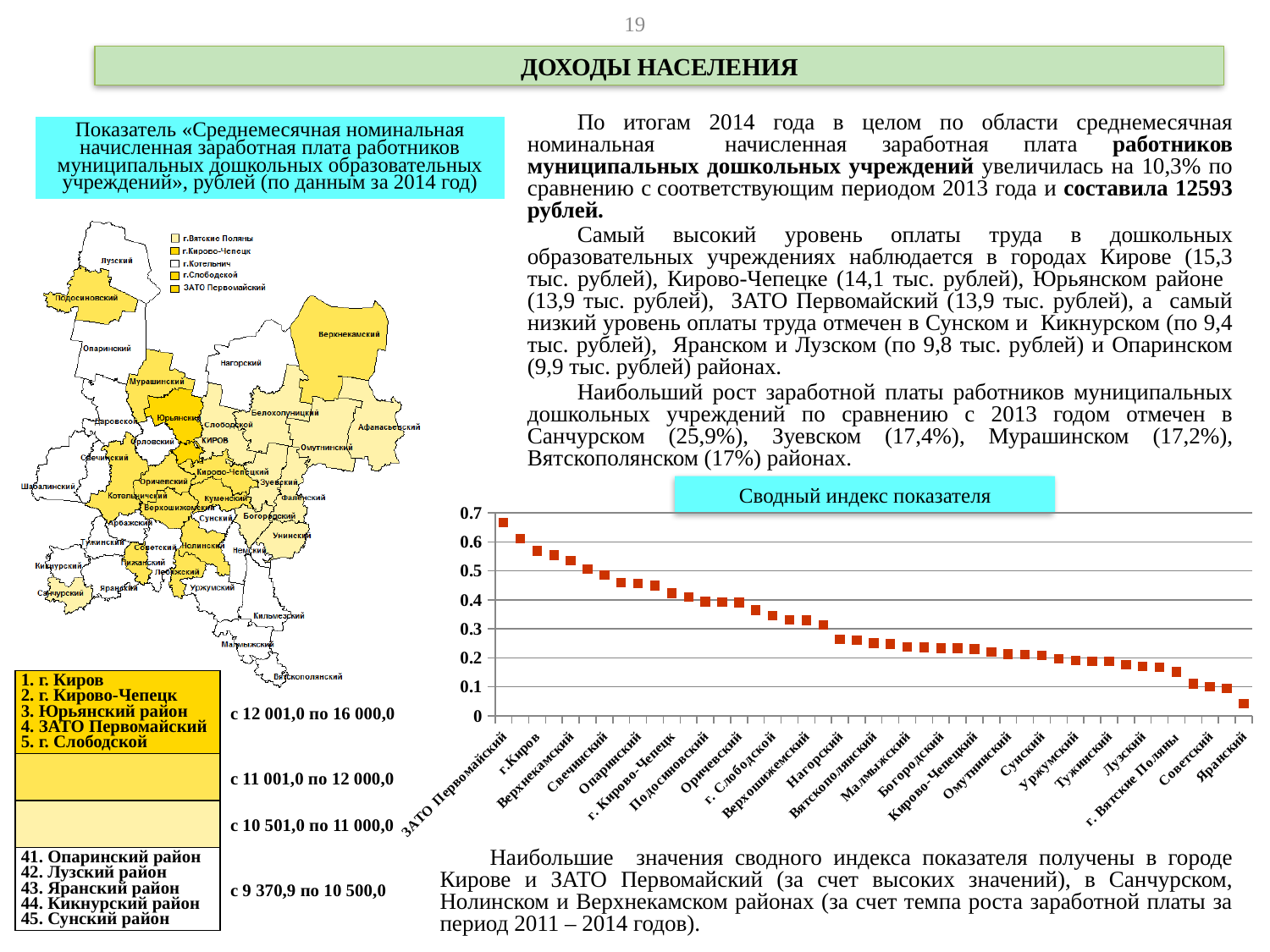
On the 'Сводный индекс показателя' chart, do the values rise or fall from left to right along the x axis? fall On the 'Сводный индекс показателя' chart, which has the larger value, Опаринский or Нагорский? Опаринский On the 'Сводный индекс показателя' chart, is the value for ЗАТО Первомайский greater or less than 0.6? greater What is the title of the chart on the slide? Сводный индекс показателя On the 'Сводный индекс показателя' chart, is the value for Лузский greater or less than 0.2? less On the 'Сводный индекс показателя' chart, which category has the highest value? ЗАТО Первомайский On the 'Сводный индекс показателя' chart, which category has the lowest value? Яранский What kind of chart is the 'Сводный индекс показателя' chart? scatter chart What is the highest tick value shown on the y axis of the 'Сводный индекс показателя' chart? 0.7 On the 'Сводный индекс показателя' chart, is the value for Яранский greater or less than 0.1? less